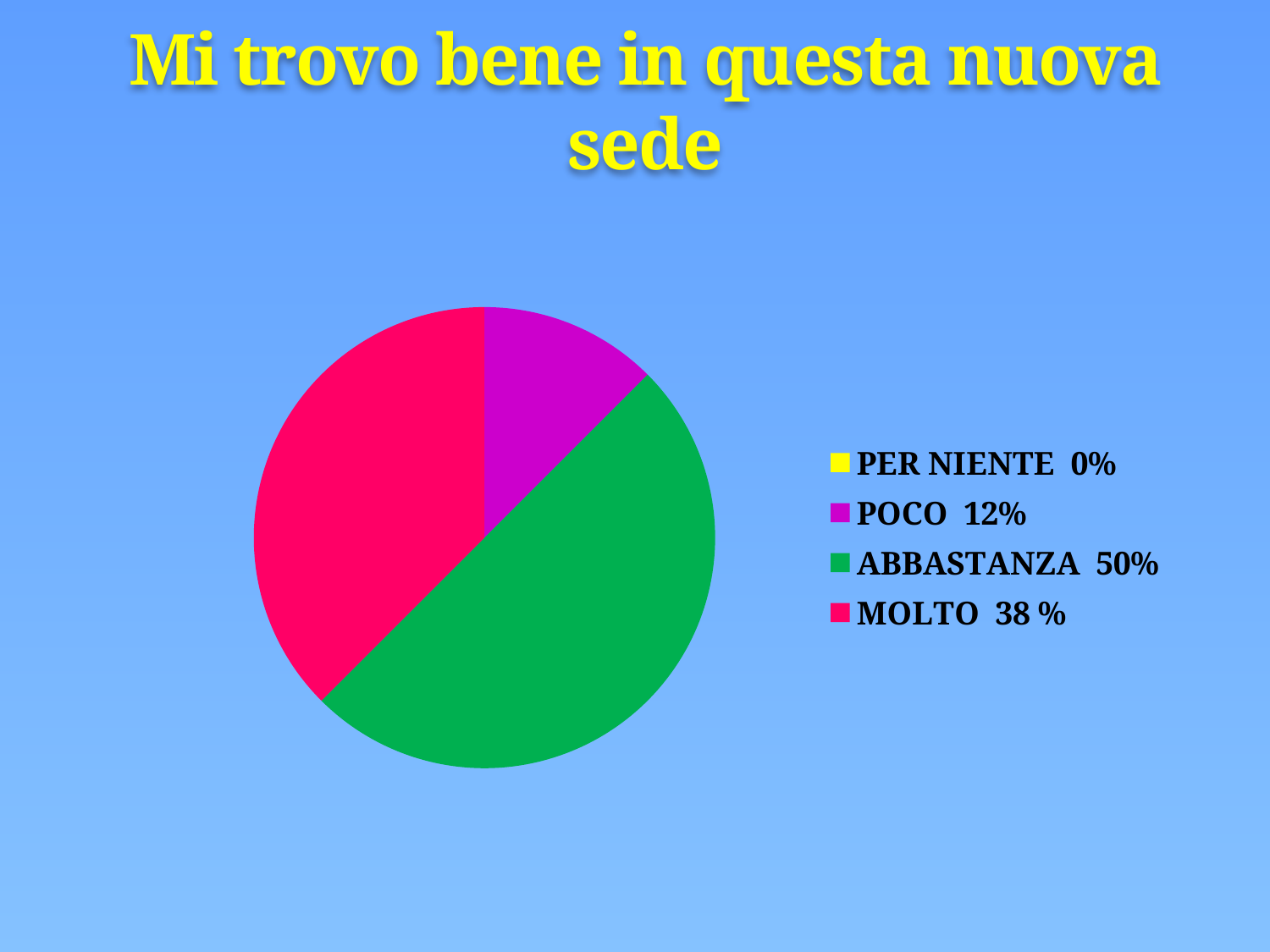
Which category has the largest share of the pie? ABBASTANZA What percentage is shown for MOLTO? 38 % What is the difference between the percentages for ABBASTANZA and MOLTO? 12% What percentage is shown for ABBASTANZA? 50% What colour is the ABBASTANZA slice of the pie? green What is the title of the slide containing the chart? Mi trovo bene in questa nuova sede Which is larger, the share for MOLTO or the share for POCO? MOLTO What percentage is shown for PER NIENTE? 0% What kind of chart is shown on the slide? pie chart Which category has the smallest share of the pie? PER NIENTE What percentage is shown for POCO? 12% How many categories does the legend list? 4